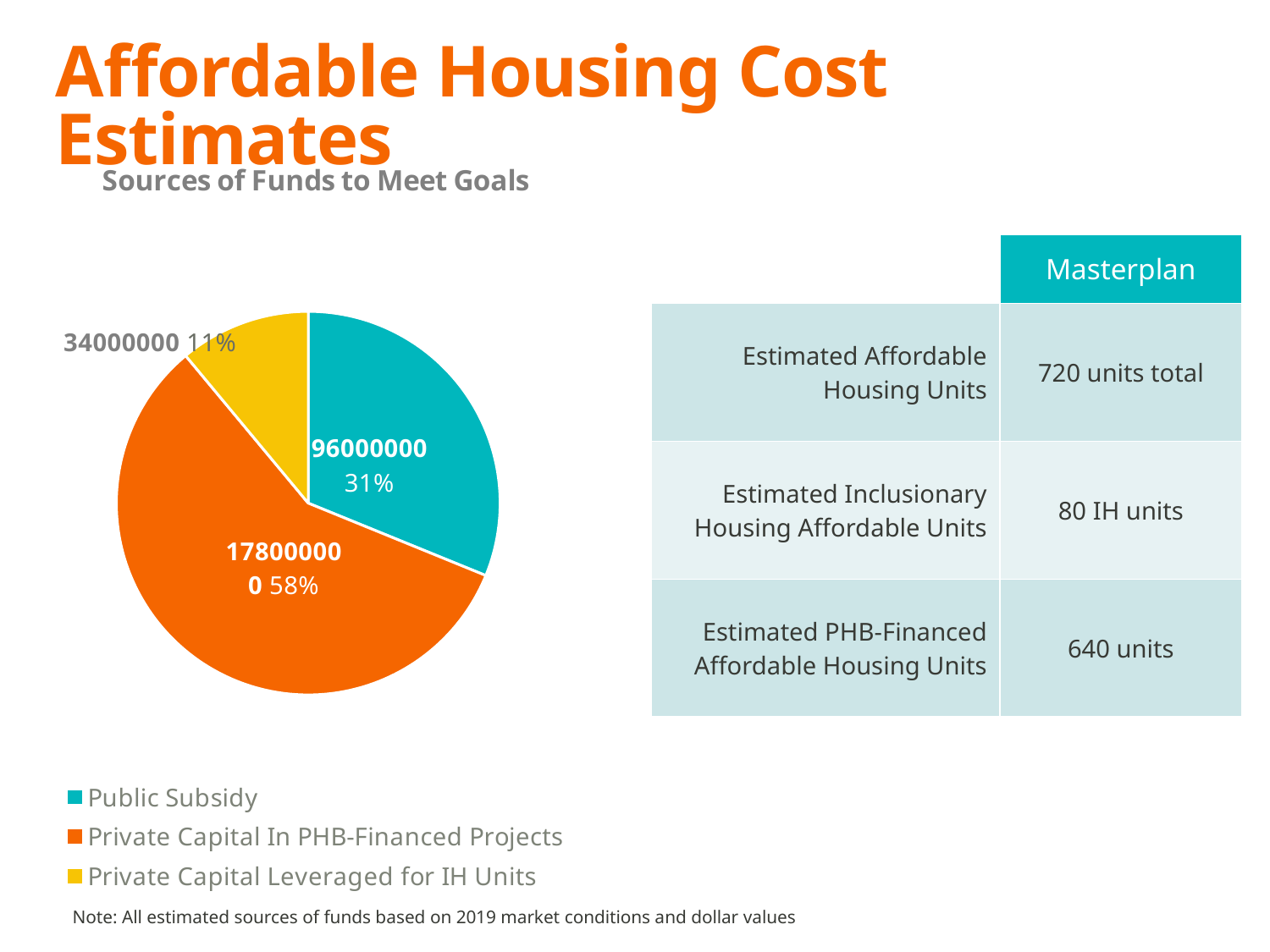
How many slices does the pie chart have? 3 What value is shown for Public Subsidy in the pie chart? 96000000 What value is shown for Private Capital Leveraged for IH Units in the pie chart? 34000000 Which source of funds is the largest slice of the pie chart? Private Capital In PHB-Financed Projects How many entries does the legend of the pie chart list? 3 Which is larger in the pie chart: Public Subsidy or Private Capital Leveraged for IH Units? Public Subsidy What value is shown for Private Capital In PHB-Financed Projects in the pie chart? 178000000 Which source of funds is the smallest slice of the pie chart? Private Capital Leveraged for IH Units What share of the pie does Public Subsidy represent? 31% What share of the pie does Private Capital In PHB-Financed Projects represent? 58% What type of chart is shown on the slide? pie chart What is the title of the pie chart? Sources of Funds to Meet Goals